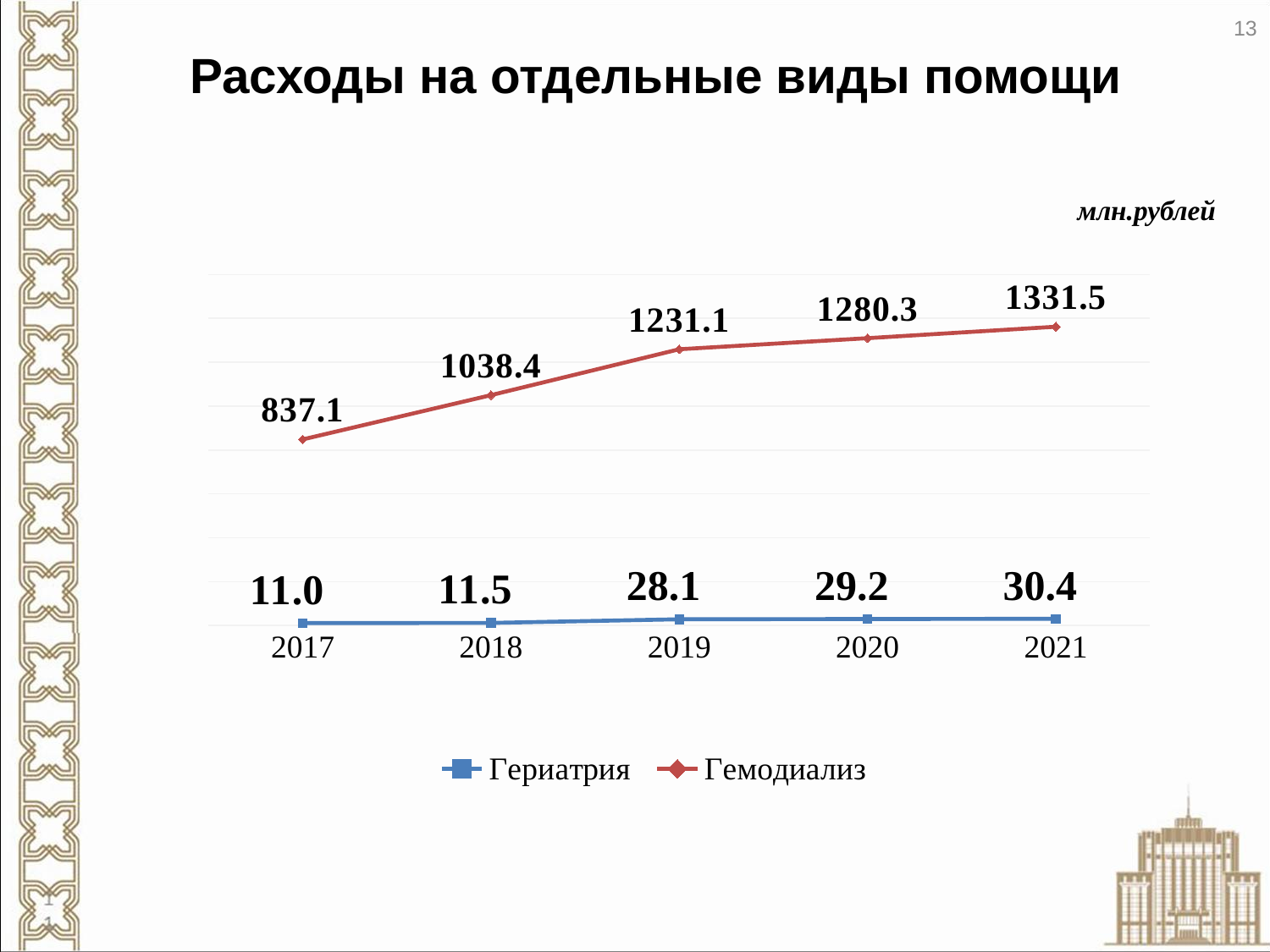
What is the difference between the Гериатрия values for 2019 and 2018? 16.6 What kind of chart is shown on the slide? line chart Do the values for Гемодиализ rise or fall from 2017 to 2021? rise What is the value for Гериатрия in 2017? 11.0 In which year is the value for Гемодиализ highest? 2021 How many years are shown on the x axis? 5 What is the value for Гериатрия in 2021? 30.4 What is the difference between the Гемодиализ values for 2021 and 2017? 494.4 How many series does the legend list? 2 What is the value for Гемодиализ in 2019? 1231.1 Which is larger: the Гемодиализ value in 2018 or in 2020? 2020 In which year is the value for Гериатрия lowest? 2017